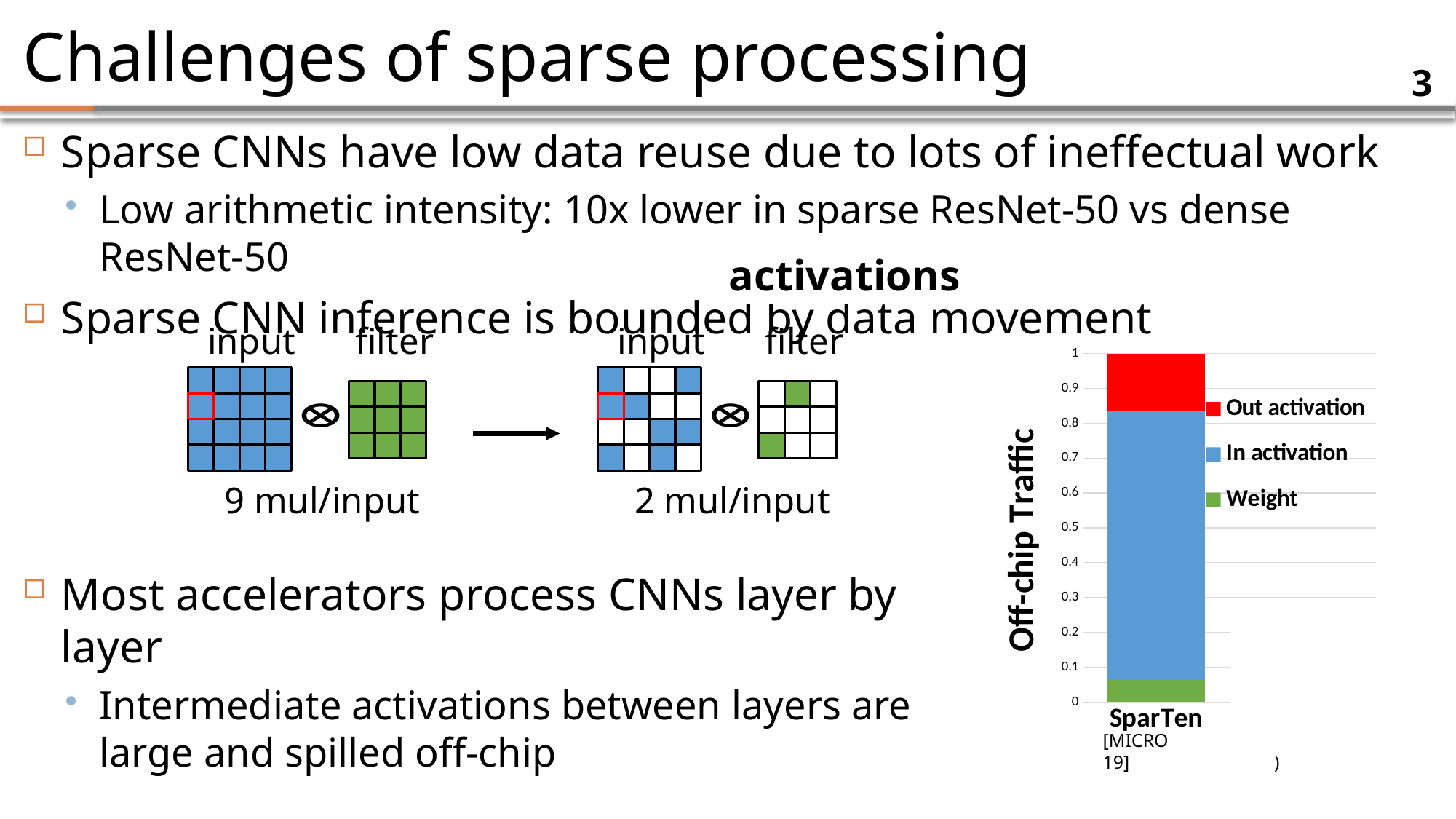
Which segment of the SparTen bar is larger, Out activation or Weight? Out activation Is the Weight segment of the SparTen bar greater or less than 0.1? less What is the label of the single bar in the Off-chip Traffic chart? SparTen Which series makes up the smallest segment of the SparTen bar? Weight How many categories are plotted on the x axis of the Off-chip Traffic chart? 1 Which series makes up the largest segment of the SparTen bar? In activation What is the y-axis title of the stacked bar chart? Off-chip Traffic What is the total height of the stacked SparTen bar on the Off-chip Traffic axis? 1 Is the Out activation segment of the SparTen bar greater or less than 0.3? less Is the In activation segment of the SparTen bar greater or less than 0.5? greater How many series does the legend of the Off-chip Traffic chart list? 3 What kind of chart is shown on the right of the slide? stacked bar chart